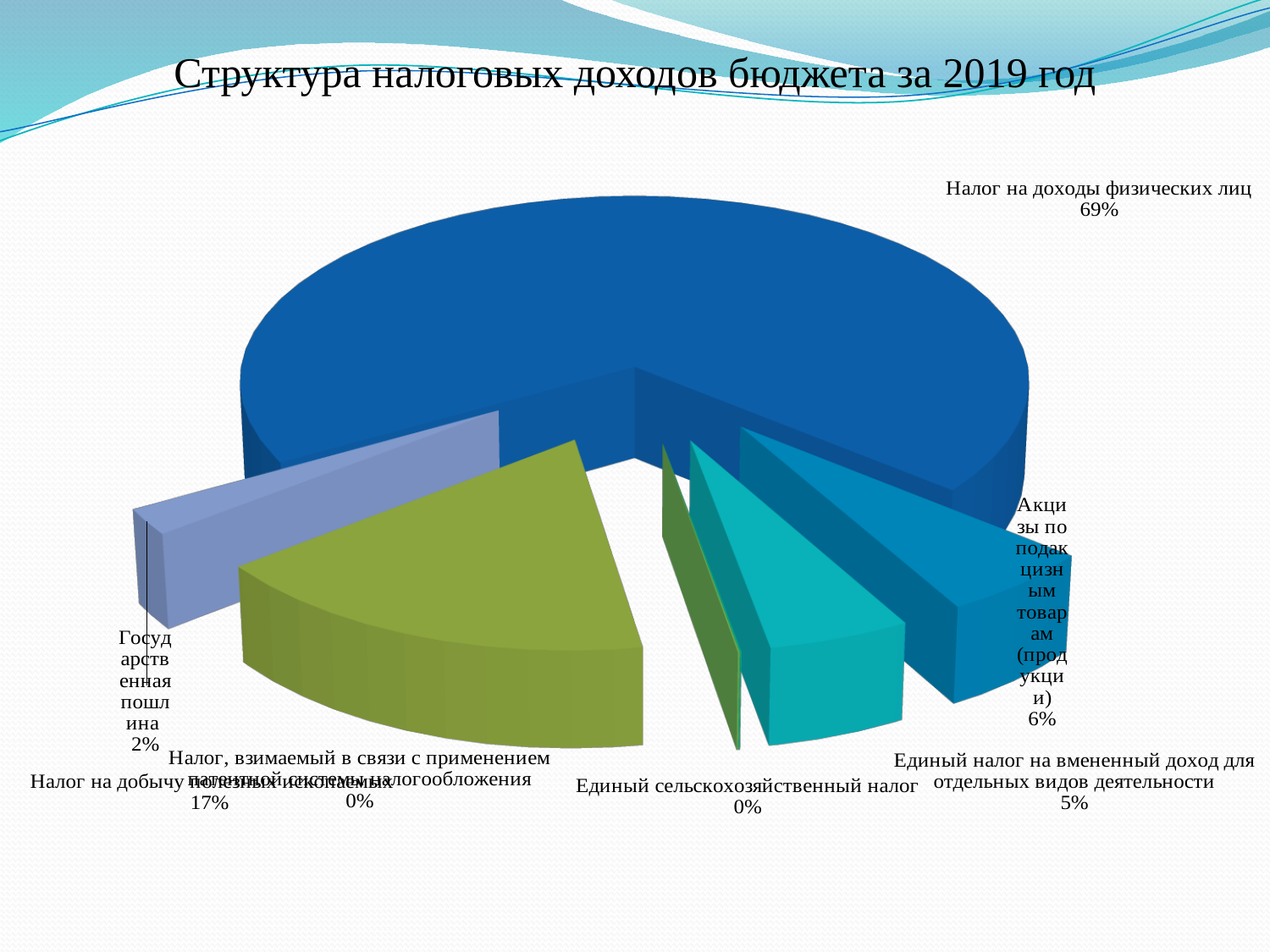
How many categories (slices) are labelled on the pie chart? 7 What share of the pie does "Налог на добычу полезных ископаемых" have? 17% What share of the pie does "Акцизы по подакцизным товарам (продукции)" have? 6% What share of the pie does "Государственная пошлина" have? 2% Which has the larger share: "Акцизы по подакцизным товарам (продукции)" or "Государственная пошлина"? Акцизы по подакцизным товарам (продукции) What kind of chart is shown on the slide? pie chart What is the title of the chart? Структура налоговых доходов бюджета за 2019 год What is the difference in share between "Налог на доходы физических лиц" and "Налог на добычу полезных ископаемых"? 52% Which category has the largest share of the pie? Налог на доходы физических лиц